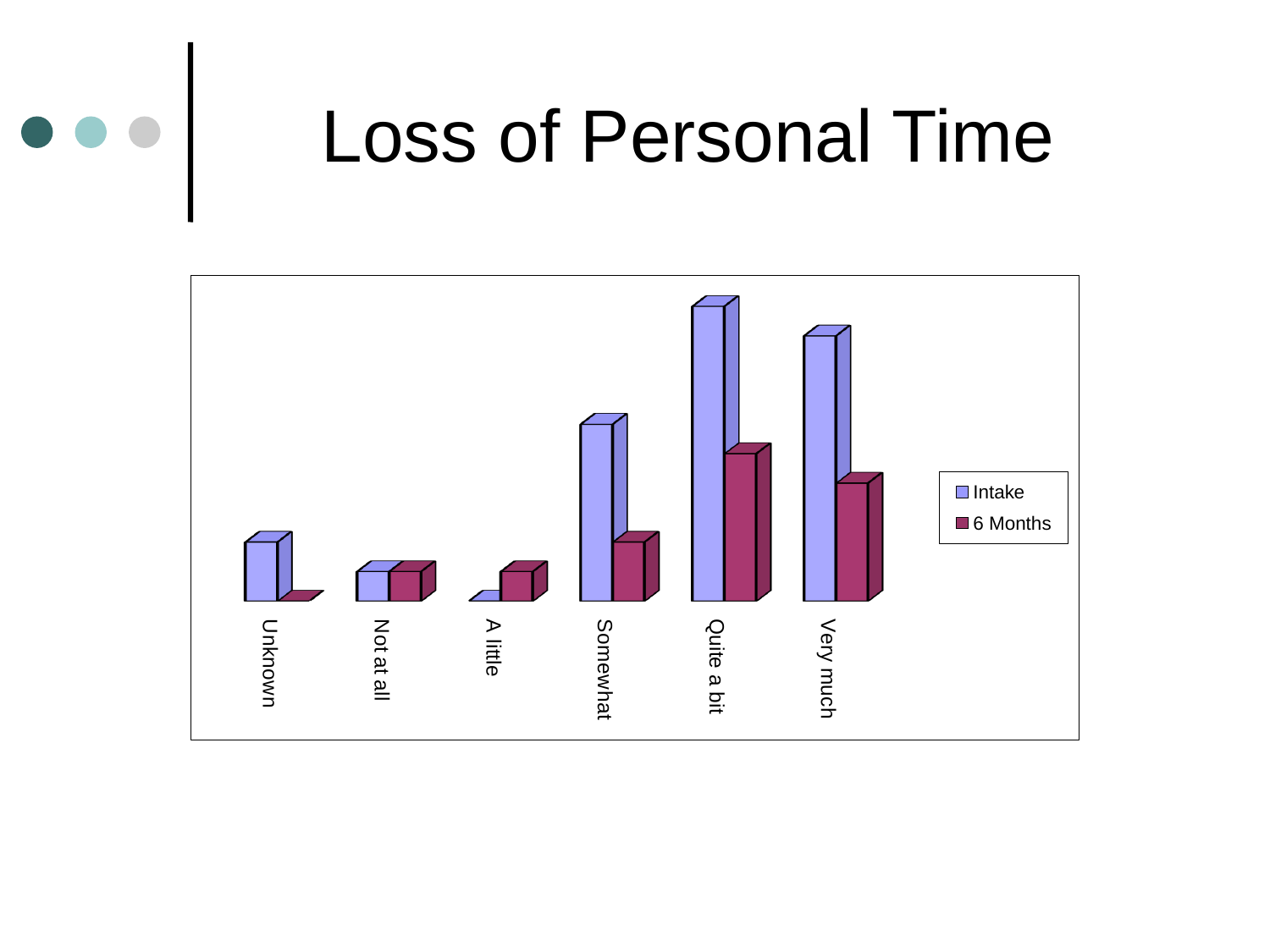
What kind of chart is shown on the slide? bar chart How many categories are shown on the x axis of the chart? 6 How many series does the legend list? 2 Which category has the highest Intake value? Quite a bit Which category has the lowest Intake value? A little For the Somewhat category, which is larger: Intake or 6 Months? Intake What is the title of the slide containing the chart? Loss of Personal Time Which category has the lowest 6 Months value? Unknown Which category has the highest 6 Months value? Quite a bit Which series is larger for Quite a bit: Intake or 6 Months? Intake For the Very much category, which is larger: Intake or 6 Months? Intake